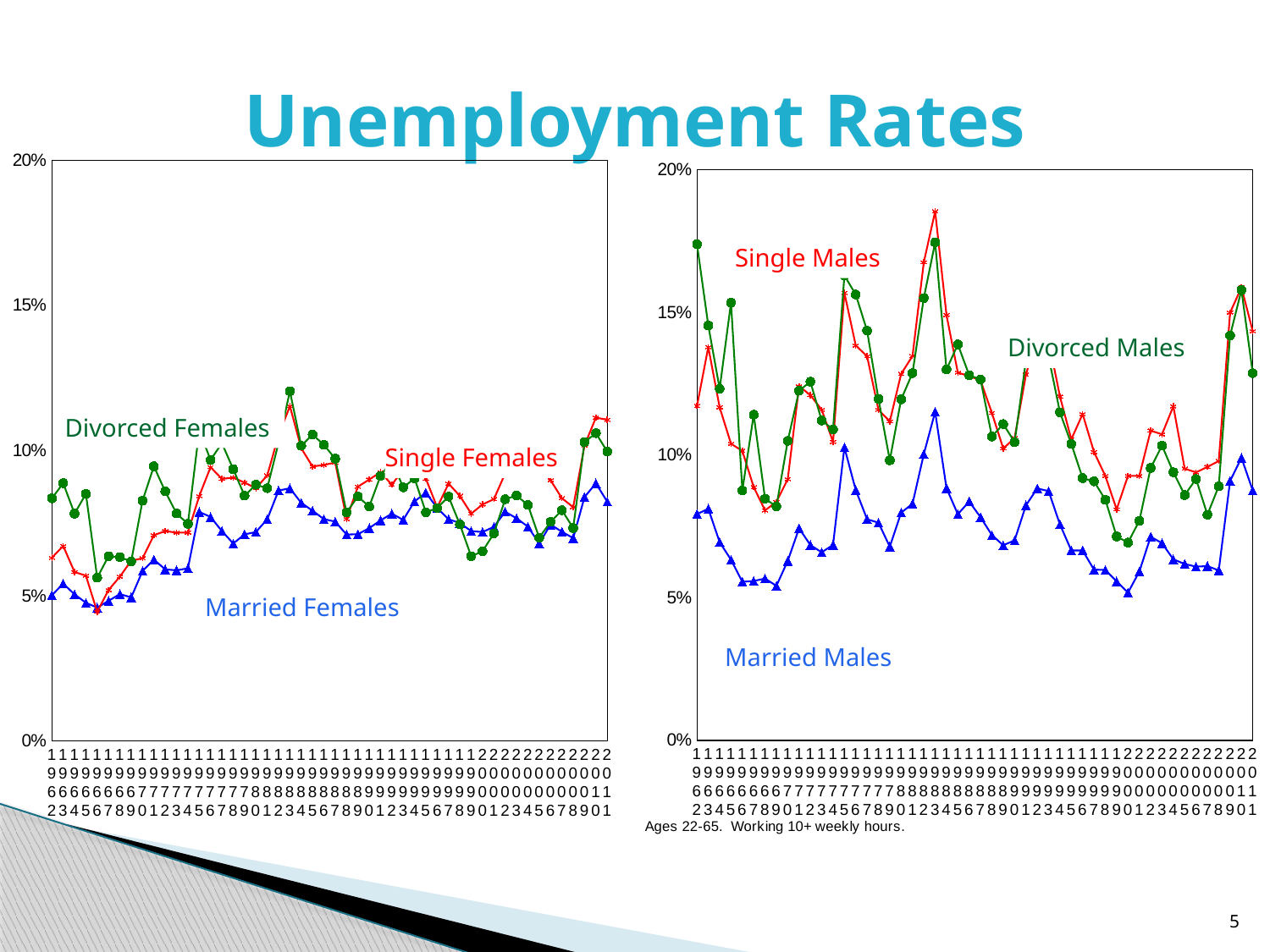
In the right chart (males), does the Single Males line rise or fall from 1980 to 1983? rise In the right chart (males), is the peak value for Single Males around 1983 greater or less than 15%? greater In the right chart (males), is the value for Married Males in 1983 greater or less than 10%? greater What colour is the Married Males line in the right chart? blue In the left chart (females), which series is generally the lowest across the years? Married Females How many series are plotted in the right chart (males)? 3 In the right chart (males), which is larger in 1962: Divorced Males or Married Males? Divorced Males What kind of chart is the left chart on the slide? line chart In the left chart (females), which is larger in 1962: Divorced Females or Married Females? Divorced Females What is the title of the slide's charts? Unemployment Rates